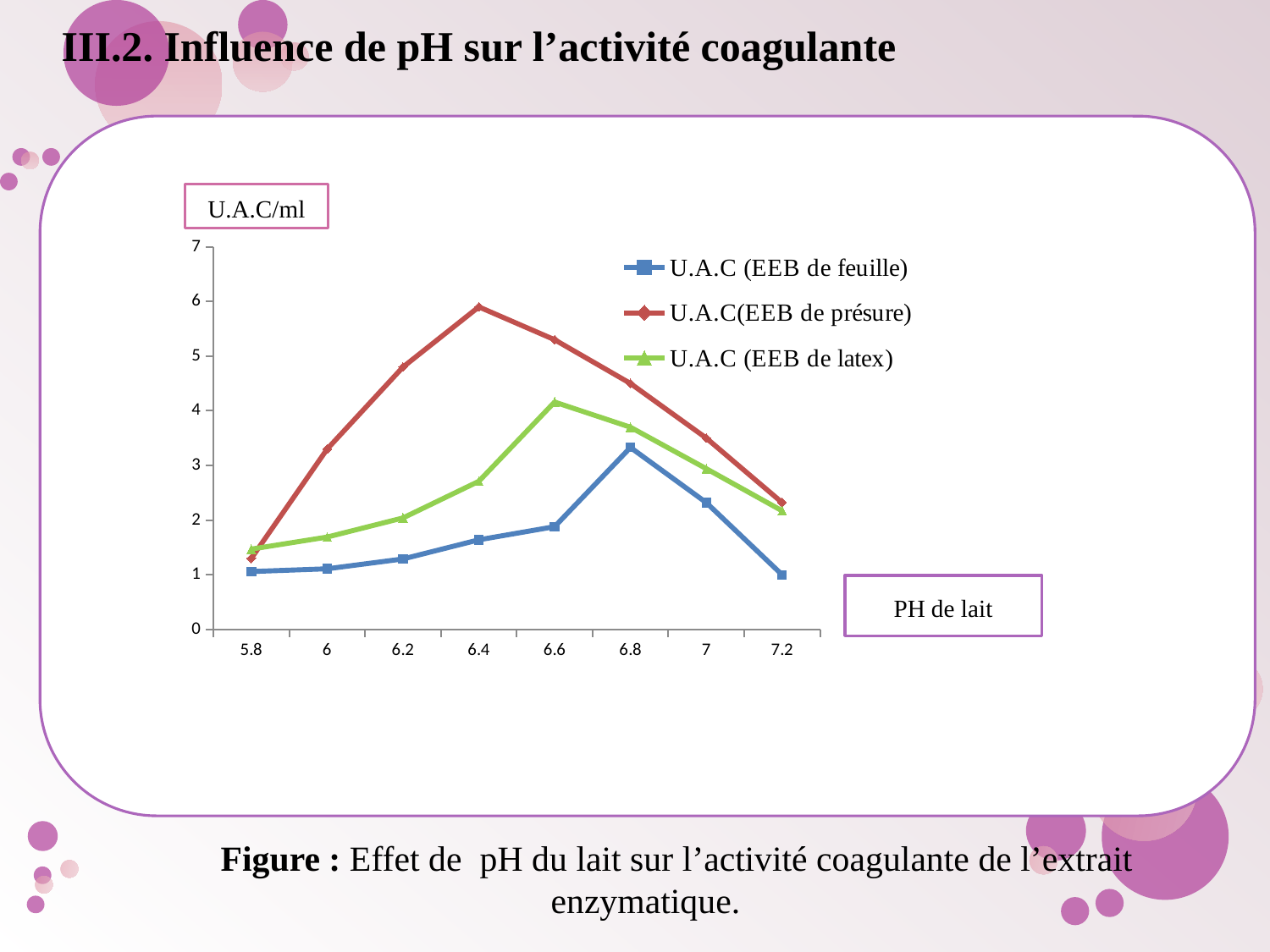
What kind of chart is shown on the slide? line chart At which pH does the U.A.C(EEB de présure) series reach its highest value? 6.4 At which pH does the U.A.C (EEB de feuille) series reach its highest value? 6.8 Is the value for U.A.C (EEB de feuille) at pH 7.2 greater or less than 2? less How many pH values are plotted along the x axis? 8 What label is shown for the x axis of the chart? PH de lait Does the U.A.C (EEB de feuille) series rise or fall between pH 6.8 and pH 7.2? fall Is the value for U.A.C(EEB de présure) at pH 6.4 greater or less than 5? greater Which series reaches the highest value overall on the chart? U.A.C(EEB de présure) At pH 6.4, which is larger: U.A.C(EEB de présure) or U.A.C (EEB de feuille)? U.A.C(EEB de présure) How many series does the legend list? 3